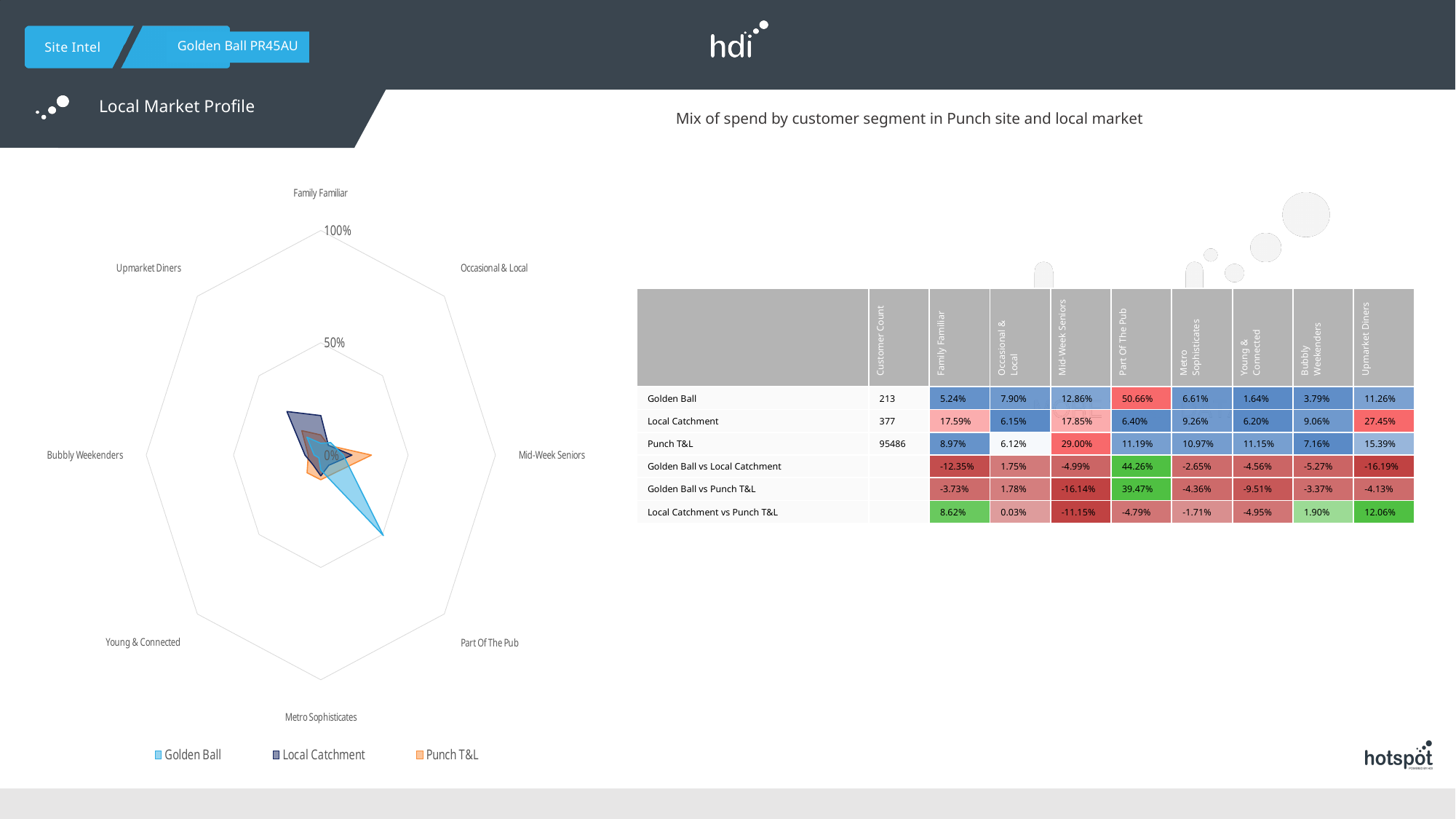
Which customer segment has the highest value for Golden Ball? Part Of The Pub Which customer segment has the lowest value for Golden Ball? Young & Connected How many series does the legend of the radar chart list? 3 What is the Punch T&L value for Mid-Week Seniors? 29.00% On the radar chart, is the Punch T&L value for Mid-Week Seniors greater or less than 50%? less How many customer segment axes does the radar chart have? 8 For Family Familiar, which is larger: Golden Ball or Local Catchment? Local Catchment What kind of chart is shown on the left of the slide? Radar chart What is the Local Catchment value for Upmarket Diners? 27.45% What colour represents Punch T&L in the radar chart legend? Orange What is the Golden Ball value for Part Of The Pub? 50.66% What is the difference between Golden Ball and Local Catchment for Part Of The Pub? 44.26%